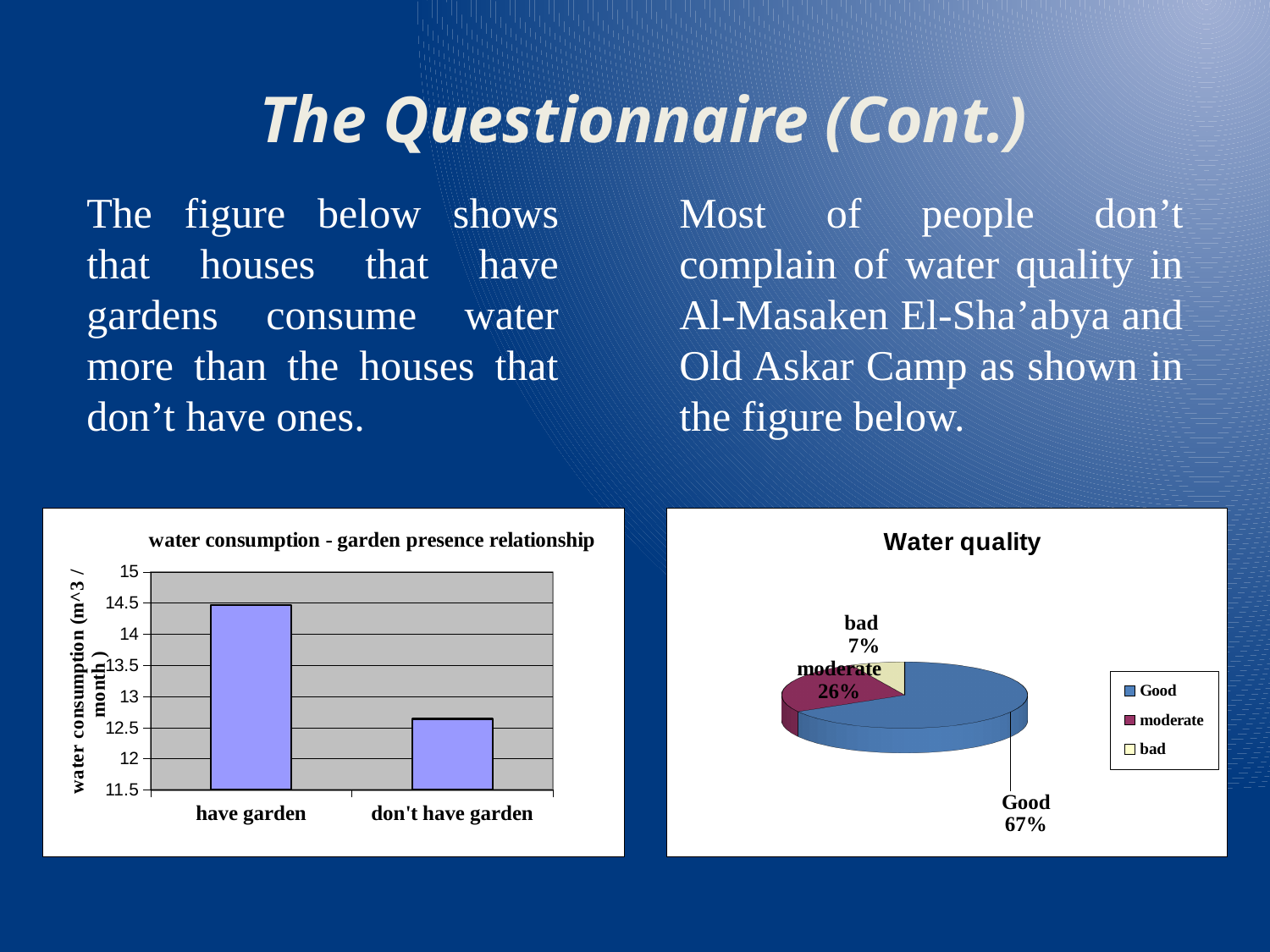
In the 'water consumption - garden presence relationship' chart, which category has the lower water consumption? don't have garden In the 'Water quality' chart, what is the difference between the 'Good' and 'moderate' shares? 41% In the 'water consumption - garden presence relationship' chart, which category has the higher water consumption? have garden In the 'water consumption - garden presence relationship' chart, is the value for 'don't have garden' greater or less than 13? less In the 'water consumption - garden presence relationship' chart, what is the label of the vertical axis? water consumption (m^3 / month) In the 'water consumption - garden presence relationship' chart, how many categories are plotted? 2 In the 'Water quality' chart, which category has the smallest slice? bad In the 'Water quality' chart, what share of responses is 'Good'? 67% In the 'Water quality' chart, what share of responses is 'moderate'? 26% In the 'water consumption - garden presence relationship' chart, what kind of chart is shown? bar chart In the 'water consumption - garden presence relationship' chart, is the value for 'have garden' greater or less than 14? greater In the 'Water quality' chart, what share of responses is 'bad'? 7%